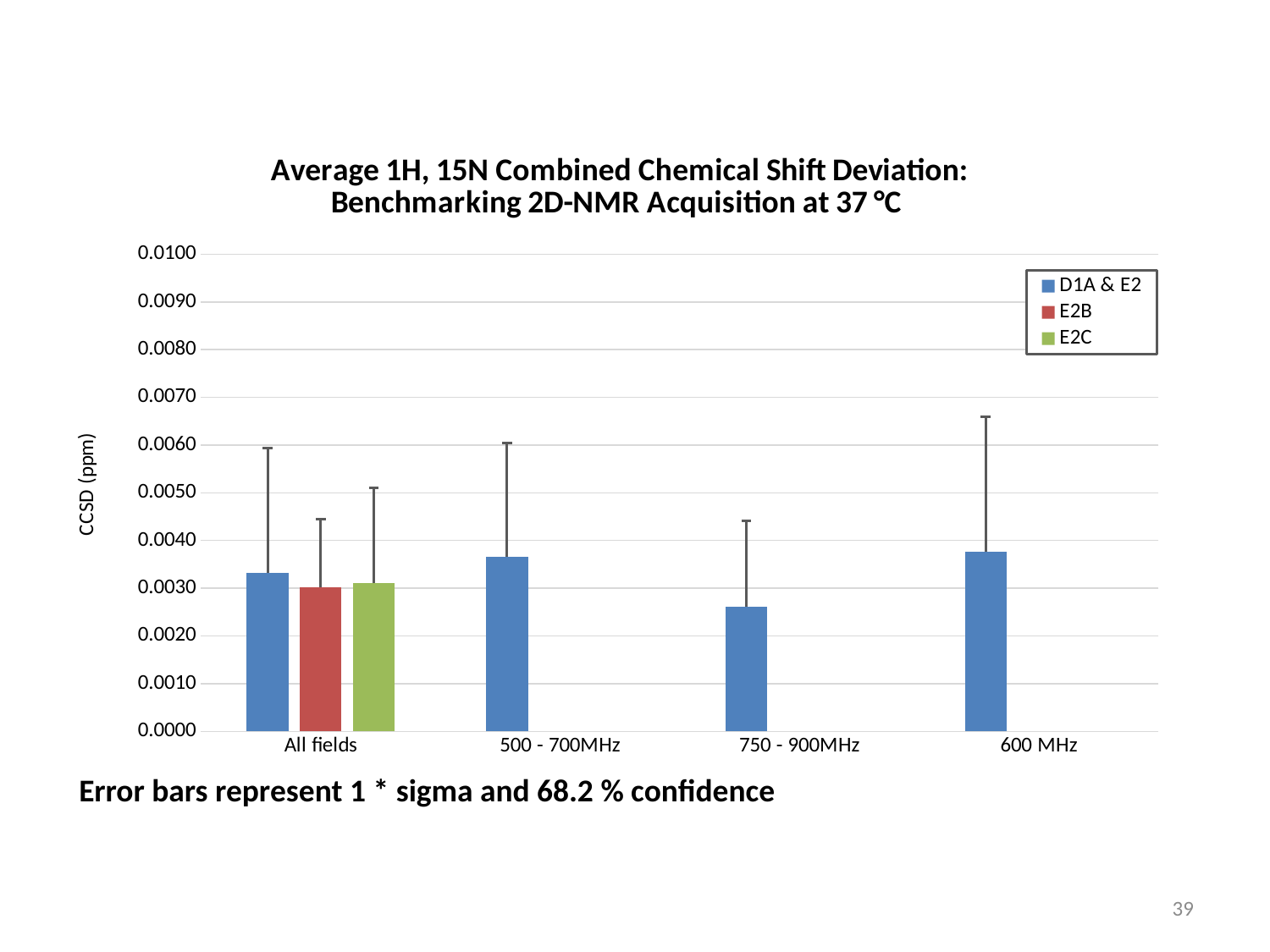
Is the E2B value for All fields greater or less than 0.0040? less What kind of chart is shown on the slide? bar chart What is the label of the y axis? CCSD (ppm) Which is larger, the D1A & E2 value for 600 MHz or for 750 - 900MHz? 600 MHz Is the D1A & E2 value for 500 - 700MHz greater or less than 0.0040? less Among the D1A & E2 bars, which category has the lowest value? 750 - 900MHz Which is larger for All fields, the D1A & E2 value or the E2B value? D1A & E2 Is the D1A & E2 value for 600 MHz greater or less than 0.0030? greater How many series does the legend list? 3 How many categories are shown on the x axis? 4 Which series are plotted for the 'All fields' category? D1A & E2, E2B, E2C